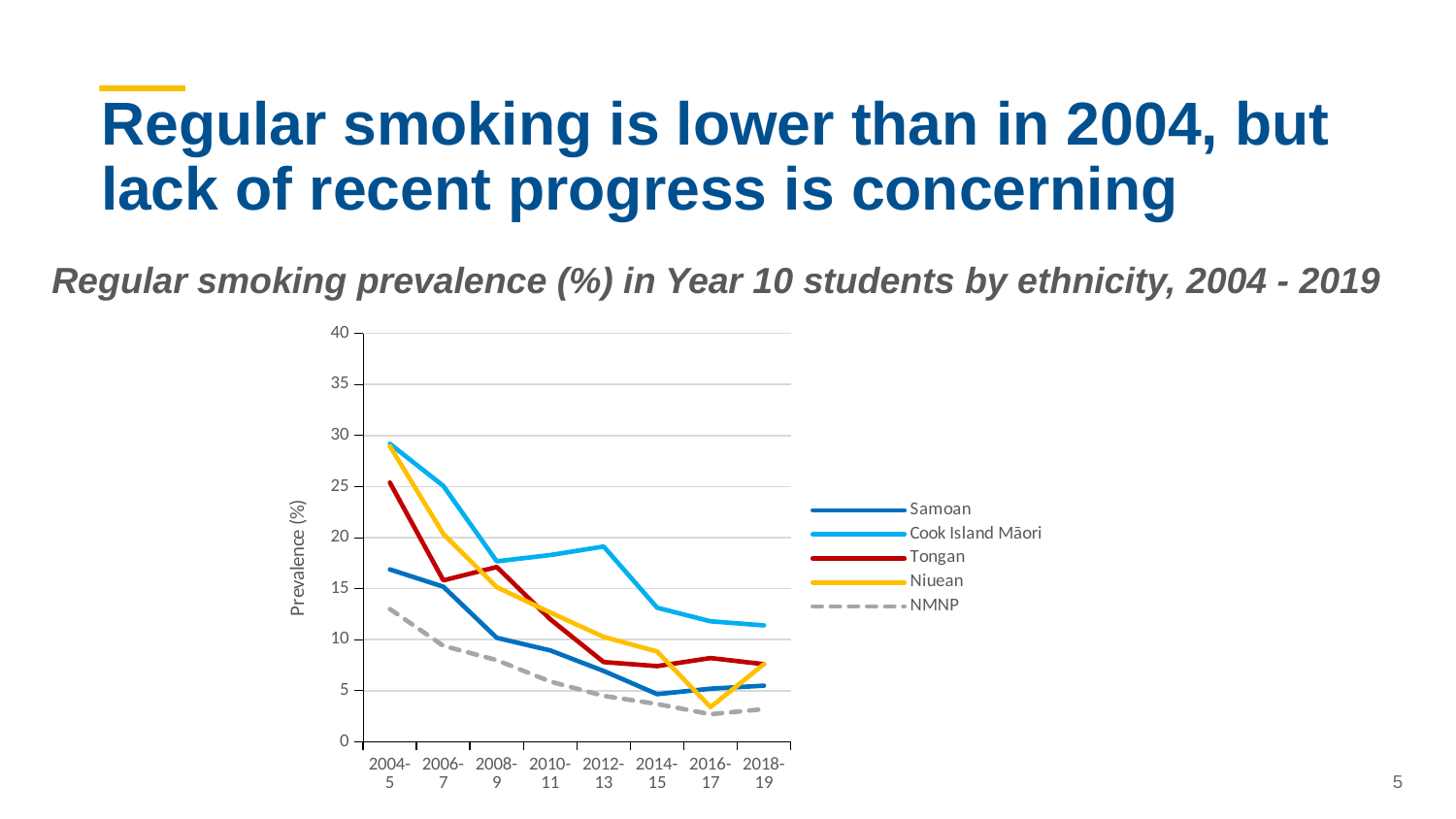
How many time periods are shown along the x axis? 8 In 2004-5, which is larger: the Tongan value or the Samoan value? Tongan Is the value for Cook Island Māori in 2004-5 greater or less than 25? greater Which series has the lowest value in 2004-5? NMNP Which series is drawn with a dashed line? NMNP In 2014-15, which is larger: the Cook Island Māori value or the Niuean value? Cook Island Māori Does the Samoan line rise or fall overall from 2004-5 to 2018-19? Fall What kind of chart is shown on the slide? Line chart Which series has the highest value in 2018-19? Cook Island Māori Is the value for Samoan in 2004-5 greater or less than 20? less How many series does the legend list? 5 Is the value for NMNP in 2016-17 greater or less than 5? less